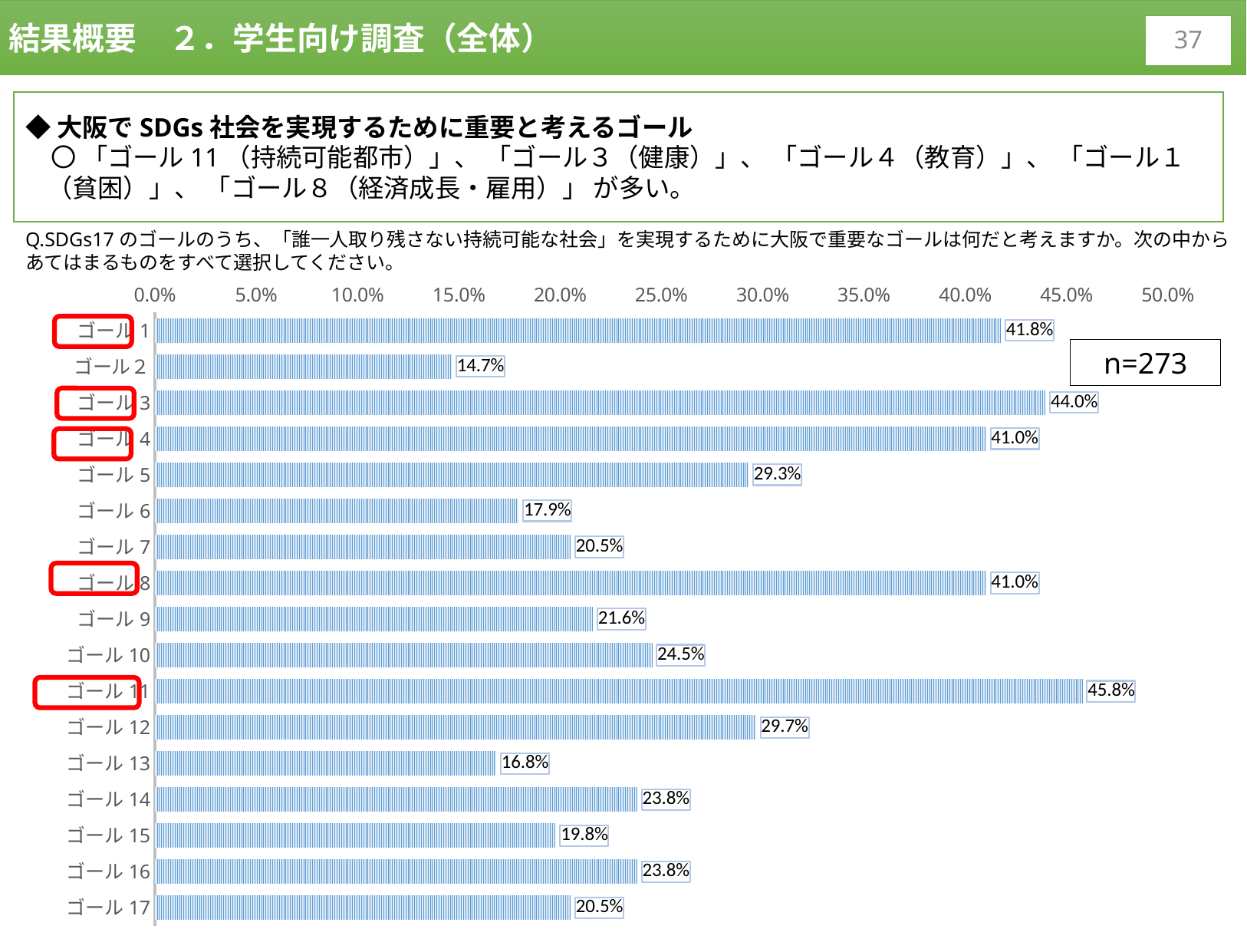
What is the difference between the values for ゴール 3 and ゴール 1? 2.2% What is the value for ゴール 11? 45.8% What is the value for ゴール 13? 16.8% How many goals (categories) are plotted in the chart? 17 Which goal has the lowest value? ゴール 2 What is the sample size (n) shown on the chart? n=273 Is the value for ゴール 10 greater or less than 25.0%? less What is the value for ゴール 2? 14.7% What kind of chart is shown on the slide? bar chart What is the difference between the values for ゴール 4 and ゴール 8? 0.0% Which is larger, the value for ゴール 5 or the value for ゴール 12? ゴール 12 Which goal has the highest value? ゴール 11